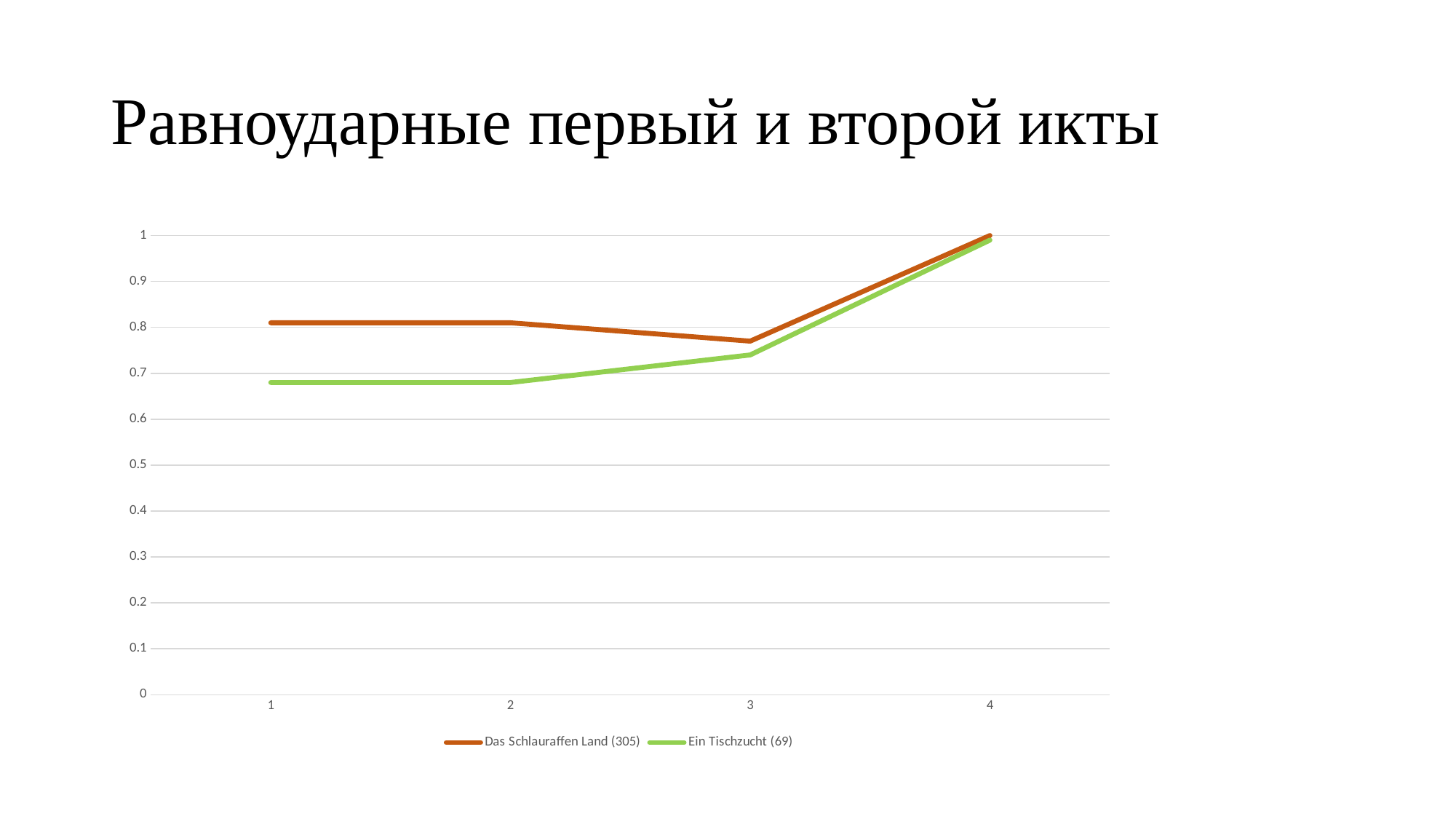
At which x value does Ein Tischzucht (69) reach its highest value? 4 Does the Ein Tischzucht (69) line rise or fall from x = 2 to x = 4? rise Is the value for Ein Tischzucht (69) at x = 1 greater or less than 0.7? less Is the value for Das Schlauraffen Land (305) at x = 1 greater or less than 0.7? greater Is the value for Das Schlauraffen Land (305) at x = 4 greater or less than 0.9? greater What is the title of the slide above the chart? Равноударные первый и второй икты At x = 1, which series has the higher value? Das Schlauraffen Land (305) At which x value does Das Schlauraffen Land (305) reach its lowest value? 3 What kind of chart is shown on the slide? line chart How many points are there along the x axis? 4 How many series does the legend list? 2